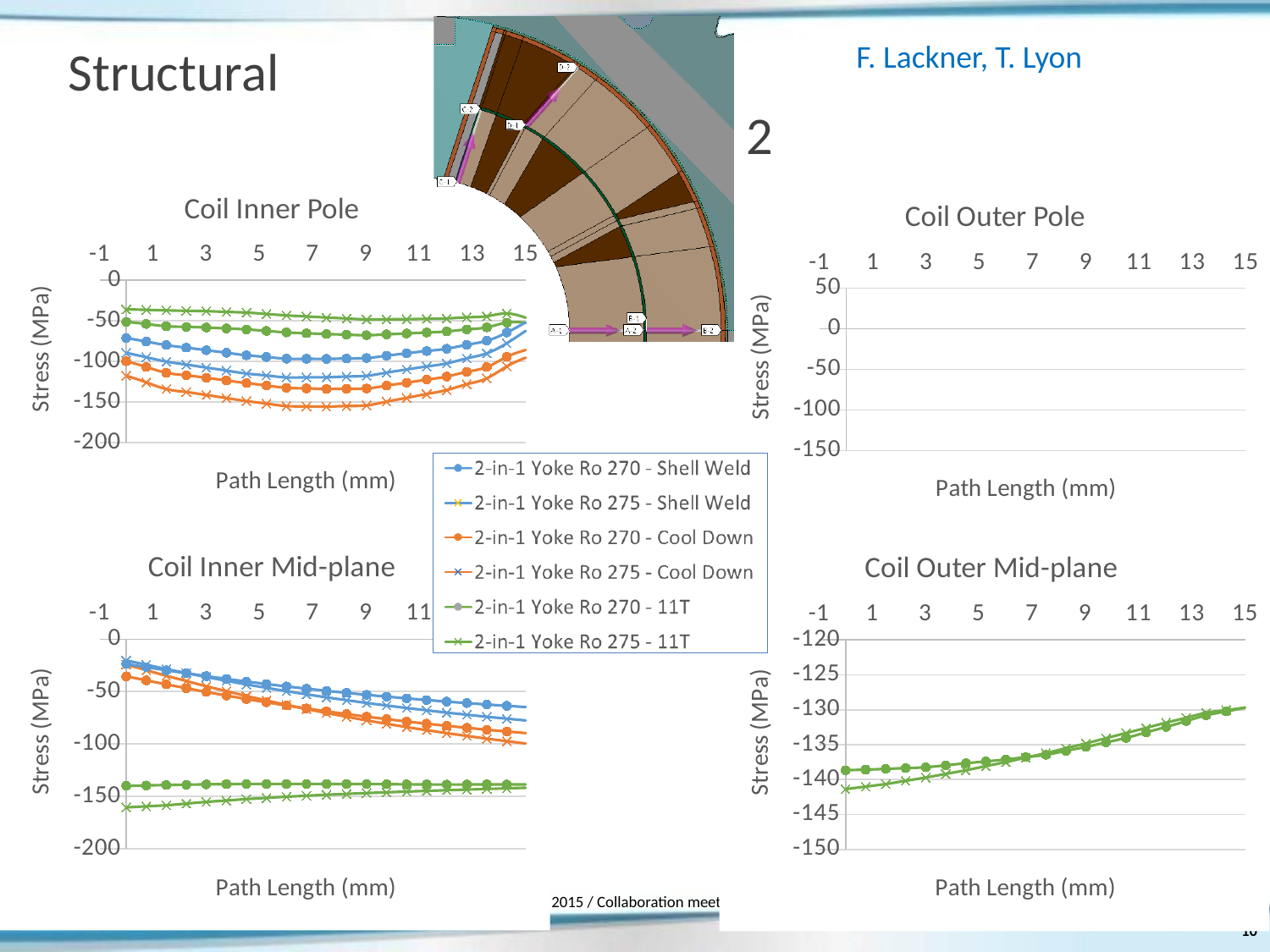
In the Coil Inner Mid-plane chart, is the value for 2-in-1 Yoke Ro 270 - Shell Weld at path length 1 greater or less than -50? greater How many series does the shared legend list for the charts on the slide? 6 In the Coil Inner Pole chart, is the value for 2-in-1 Yoke Ro 275 - Cool Down at path length 7 greater or less than -100? less In the Coil Inner Pole chart, which series has the highest stress values? 2-in-1 Yoke Ro 275 - 11T In the Coil Inner Mid-plane chart, at path length 13, which is larger: 2-in-1 Yoke Ro 270 - Shell Weld or 2-in-1 Yoke Ro 270 - 11T? 2-in-1 Yoke Ro 270 - Shell Weld In the Coil Outer Mid-plane chart, is the value for 2-in-1 Yoke Ro 270 - 11T at path length 1 greater or less than -135? less In the Coil Inner Mid-plane chart, do the values for 2-in-1 Yoke Ro 270 - Shell Weld rise or fall as path length increases? fall What is the y-axis title of the Coil Inner Mid-plane chart? Stress (MPa) What kind of chart is the Coil Inner Pole chart? line chart In the Coil Inner Pole chart, which series has the lowest stress values? 2-in-1 Yoke Ro 275 - Cool Down What is the x-axis title of the Coil Outer Mid-plane chart? Path Length (mm) In the Coil Outer Mid-plane chart, do the values rise or fall as path length increases? rise